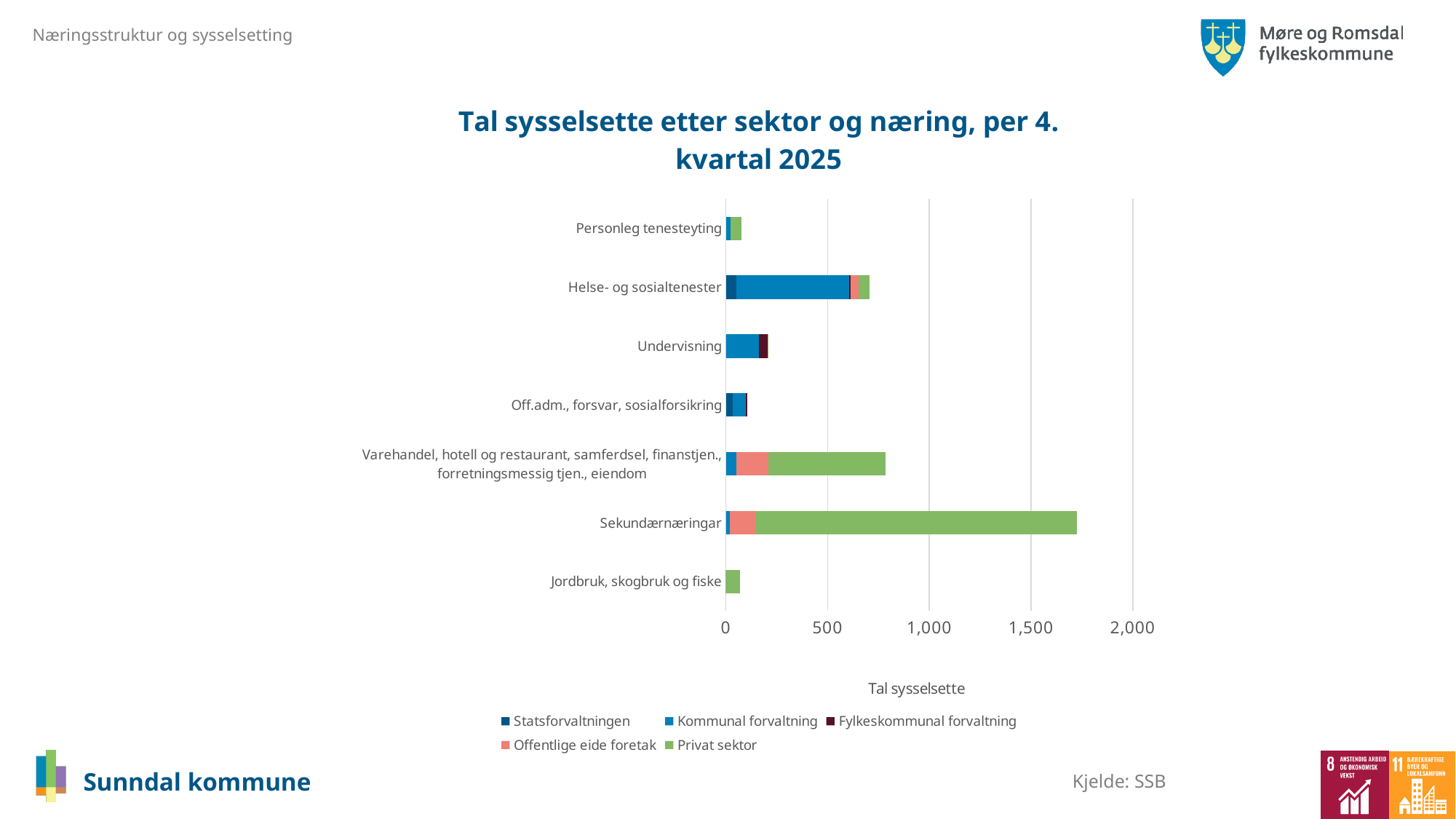
Which has the larger total bar: Helse- og sosialtenester or Undervisning? Helse- og sosialtenester How many categories (næringar) are plotted on the y axis of the chart? 7 How many series does the legend of the chart list? 5 What is the label of the x axis of the chart? Tal sysselsette What is the title of the chart? Tal sysselsette etter sektor og næring, per 4. kvartal 2025 Which has the larger total bar: Sekundærnæringar or Helse- og sosialtenester? Sekundærnæringar Which category has the longest total bar in the chart? Sekundærnæringar Is the total value for Undervisning greater or less than 500? less Is the total value for Varehandel, hotell og restaurant, samferdsel, finanstjen., forretningsmessig tjen., eiendom greater or less than 500? greater Is the total value for Off.adm., forsvar, sosialforsikring greater or less than 500? less What kind of chart is shown on the slide? Stacked bar chart